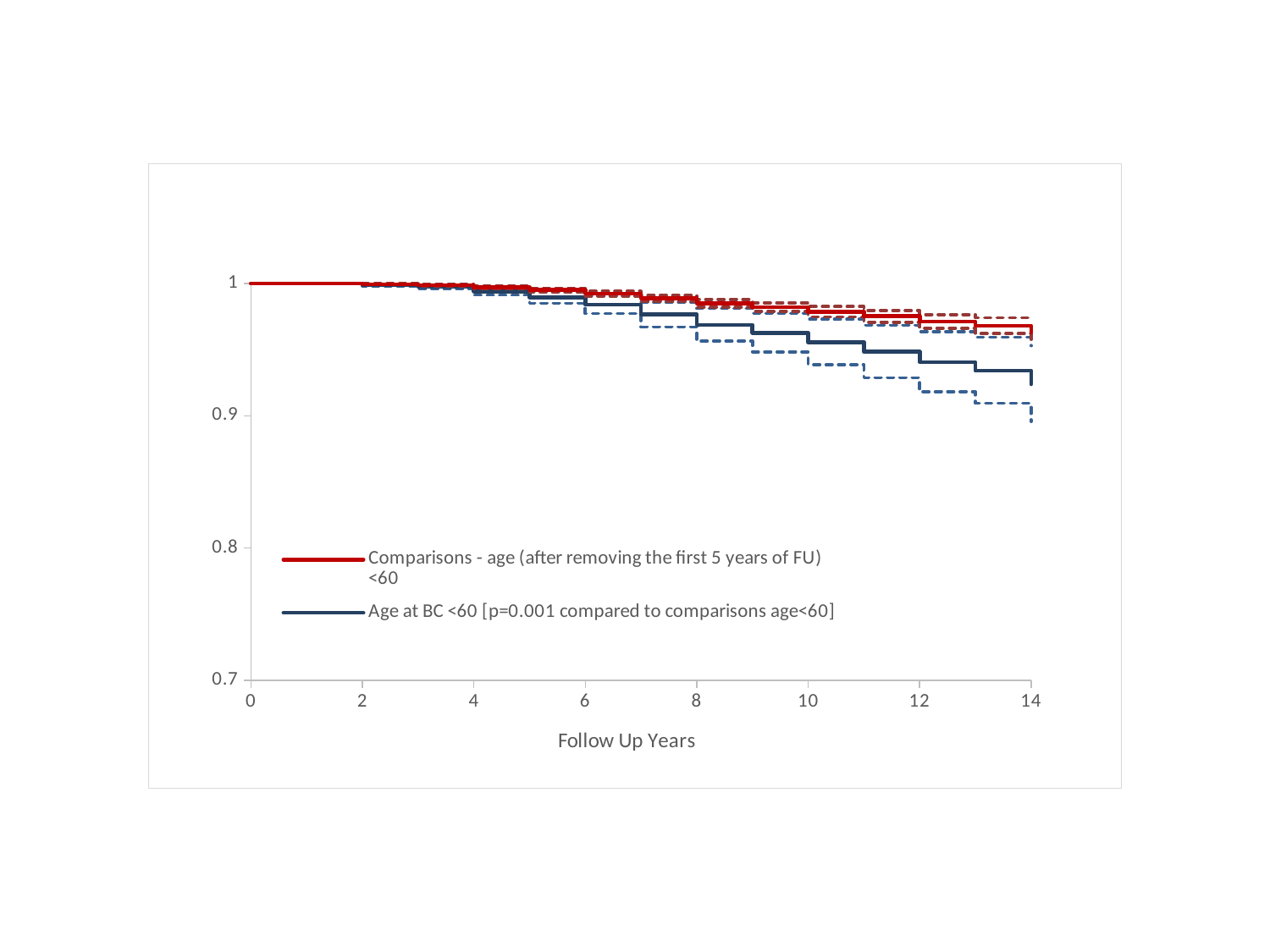
What is the label of the x axis? Follow Up Years At 14 follow-up years, which series has the higher value: the red 'Comparisons - age (after removing the first 5 years of FU) <60' line or the blue 'Age at BC <60' line? Comparisons - age (after removing the first 5 years of FU) <60 Which series is drawn in red? Comparisons - age (after removing the first 5 years of FU) <60 Do the plotted values rise or fall as follow-up years increase? fall What is the lowest value shown on the y axis? 0.7 What is the highest value shown on the x axis? 14 Is the value of the blue 'Age at BC <60' solid line at 14 follow-up years greater or less than 0.9? greater Is the value of the blue 'Age at BC <60' solid line at 10 follow-up years greater or less than 0.9? greater What p-value is stated in the legend entry for 'Age at BC <60'? p=0.001 What kind of chart is shown on the slide? line chart Is the value of the red 'Comparisons - age' solid line at 14 follow-up years greater or less than 0.9? greater How many series does the legend list? 2